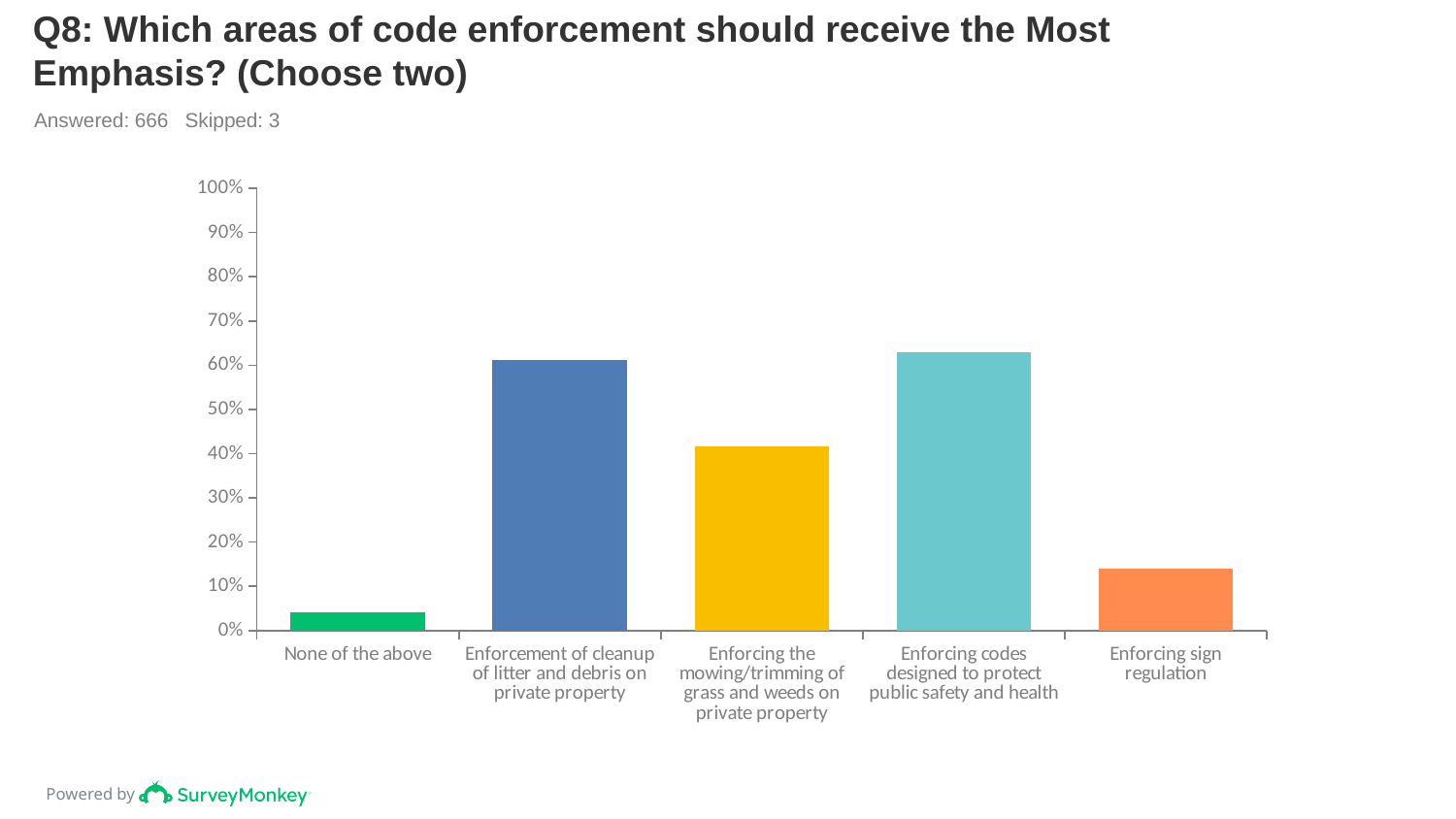
How many respondents answered the question shown in the chart title? 666 Which is larger: the value for "Enforcement of cleanup of litter and debris on private property" or the value for "Enforcing the mowing/trimming of grass and weeds on private property"? Enforcement of cleanup of litter and debris on private property How many categories are shown on the x axis of the chart? 5 Is the value for "Enforcing sign regulation" greater or less than 10%? greater Is the value for "Enforcement of cleanup of litter and debris on private property" greater or less than 50%? greater Is the value for "Enforcing codes designed to protect public safety and health" greater or less than 50%? greater Which category has the lowest value in the chart? None of the above What kind of chart is shown on the slide? bar chart What is the highest value shown on the y axis of the chart? 100% Which is larger: the value for "Enforcing the mowing/trimming of grass and weeds on private property" or the value for "Enforcing sign regulation"? Enforcing the mowing/trimming of grass and weeds on private property